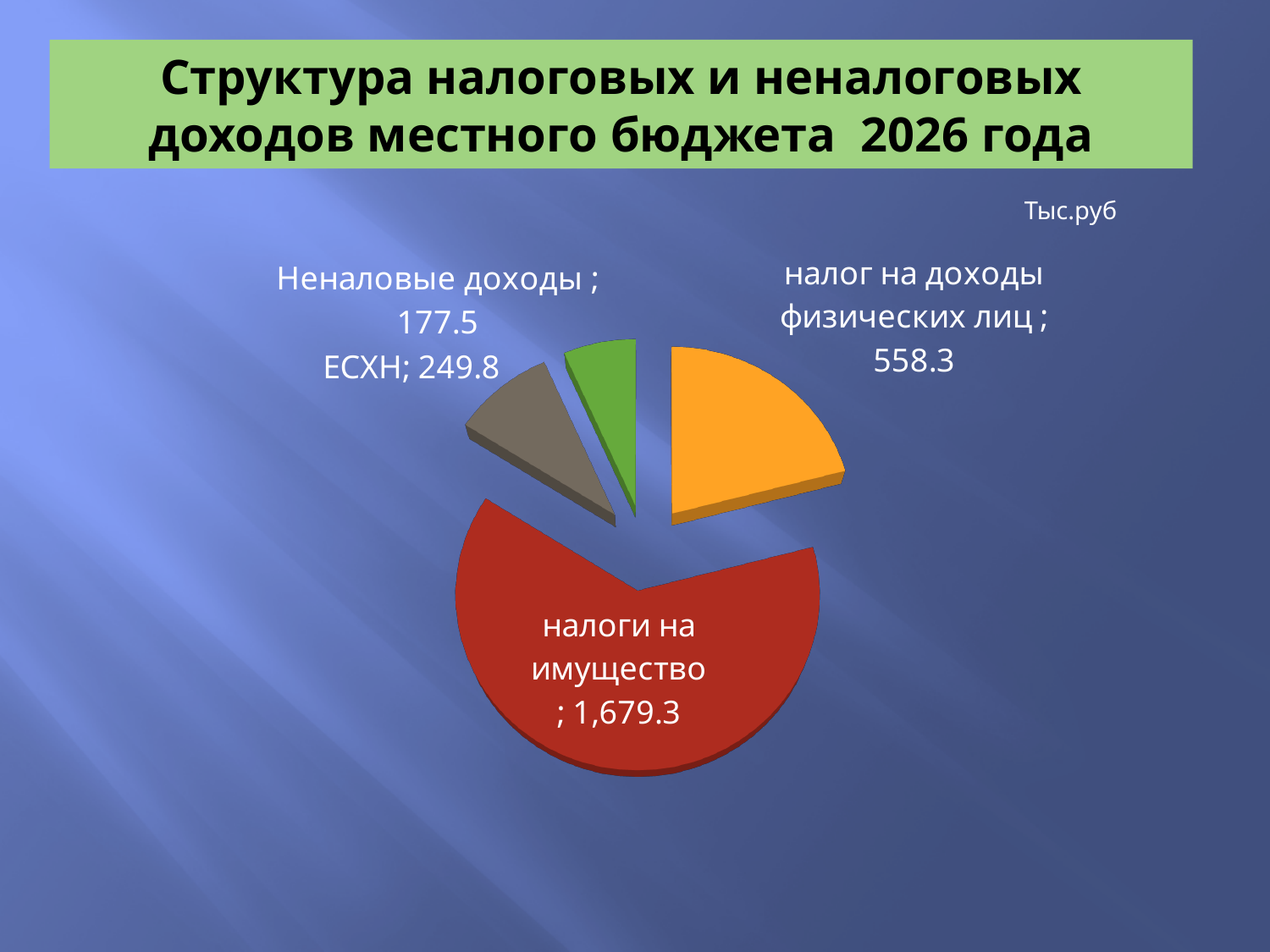
Which category has the smallest slice of the pie? Неналовые доходы What type of chart is shown on the slide? pie chart What is the value for налог на доходы физических лиц? 558.3 What is the difference between ЕСХН and Неналовые доходы? 72.3 What is the value for Неналовые доходы? 177.5 What is the value for ЕСХН? 249.8 In what units are the values on the chart given? Тыс.руб Which category has the largest slice of the pie? налоги на имущество What is the difference between налоги на имущество and налог на доходы физических лиц? 1,121.0 Which is larger, ЕСХН or налог на доходы физических лиц? налог на доходы физических лиц How many slices does the pie chart have? 4 What is the value for налоги на имущество? 1,679.3